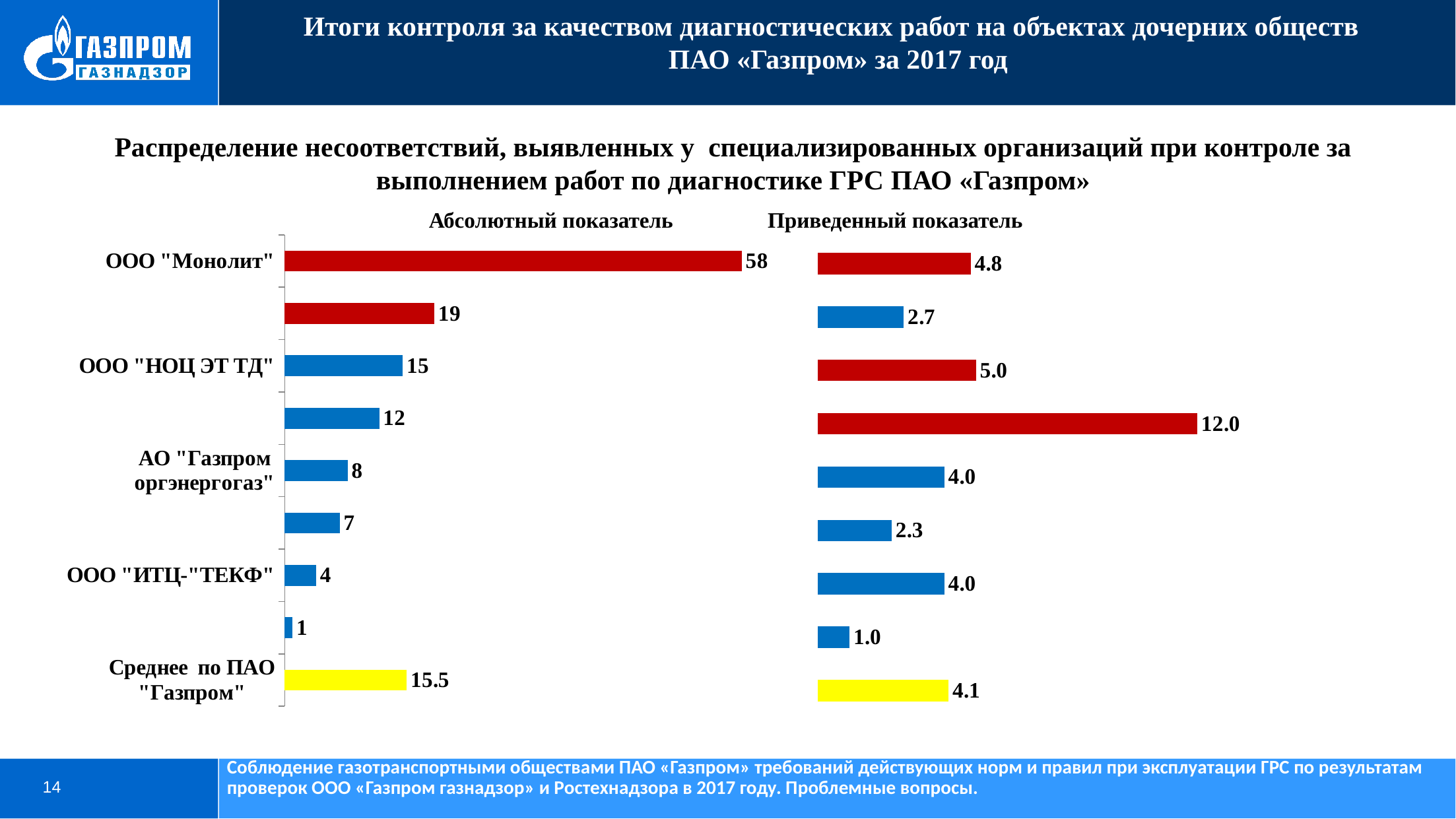
In the "Абсолютный показатель" chart, what is the value for Среднее по ПАО "Газпром"? 15.5 In the "Абсолютный показатель" chart, which organisation has the highest value? ООО "Монолит" In the "Абсолютный показатель" chart, what is the value for ООО "НОЦ ЭТ ТД"? 15 What kind of chart is the "Приведенный показатель" chart? Bar chart In the "Абсолютный показатель" chart, what is the difference between the values for ООО "Монолит" and ООО "НОЦ ЭТ ТД"? 43 In the "Приведенный показатель" chart, which is larger: the value for ООО "НОЦ ЭТ ТД" or for ООО "Монолит"? ООО "НОЦ ЭТ ТД" In the "Приведенный показатель" chart, what is the value for Среднее по ПАО "Газпром"? 4.1 In the "Абсолютный показатель" chart, what is the value for ООО "Монолит"? 58 In the "Приведенный показатель" chart, what is the value for ООО "Монолит"? 4.8 In the "Приведенный показатель" chart, what is the value for АО "Газпром оргэнергогаз"? 4.0 In the "Абсолютный показатель" chart, what colour is the bar for Среднее по ПАО "Газпром"? Yellow How many bars are plotted in the "Абсолютный показатель" chart? 9